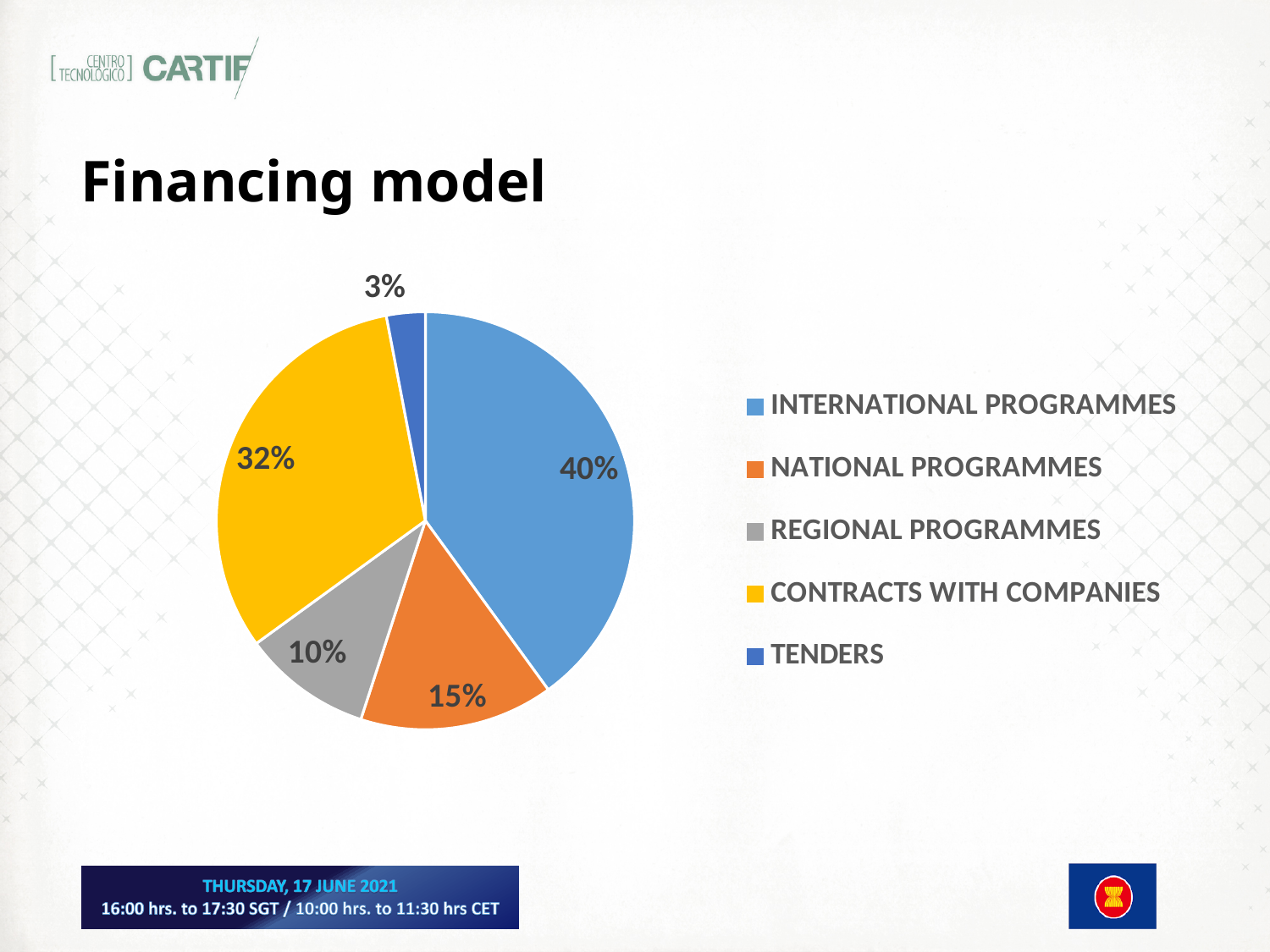
What share of the pie does INTERNATIONAL PROGRAMMES represent? 40% What is the difference between the shares of INTERNATIONAL PROGRAMMES and CONTRACTS WITH COMPANIES? 8% What is the value shown for CONTRACTS WITH COMPANIES? 32% Which is larger, NATIONAL PROGRAMMES or REGIONAL PROGRAMMES? NATIONAL PROGRAMMES What is the value shown for TENDERS? 3% What is the value shown for NATIONAL PROGRAMMES? 15% Which category has the largest slice of the pie? INTERNATIONAL PROGRAMMES What kind of chart is shown on the slide? Pie chart How many categories does the pie chart show? 5 Which category has the smallest slice of the pie? TENDERS What is the value shown for REGIONAL PROGRAMMES? 10% What colour is the slice for CONTRACTS WITH COMPANIES? Yellow